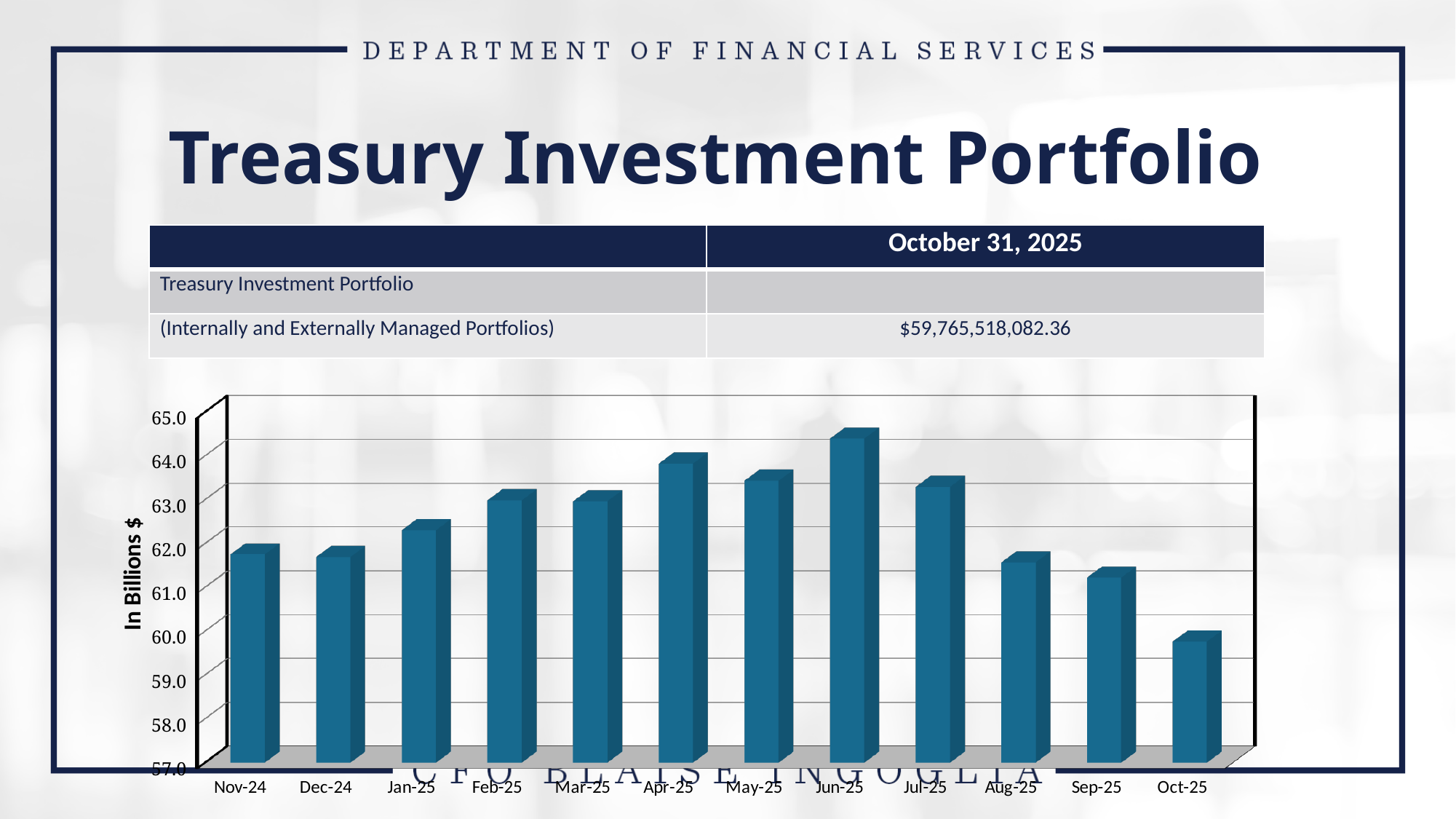
Do the values rise or fall from Jun-25 to Oct-25? fall Which month has the lowest value in the chart? Oct-25 What is the label on the vertical axis of the chart? In Billions $ Which is larger, the value for Dec-24 or the value for Jan-25? Jan-25 What kind of chart is shown on the slide? bar chart How many months are plotted in the chart? 12 Is the value for Jun-25 greater or less than 64.0? greater Which is larger, the value for Apr-25 or the value for Feb-25? Apr-25 Is the value for Feb-25 greater or less than 64.0? less Is the value for Apr-25 greater or less than 63.0? greater Which month has the highest value in the chart? Jun-25